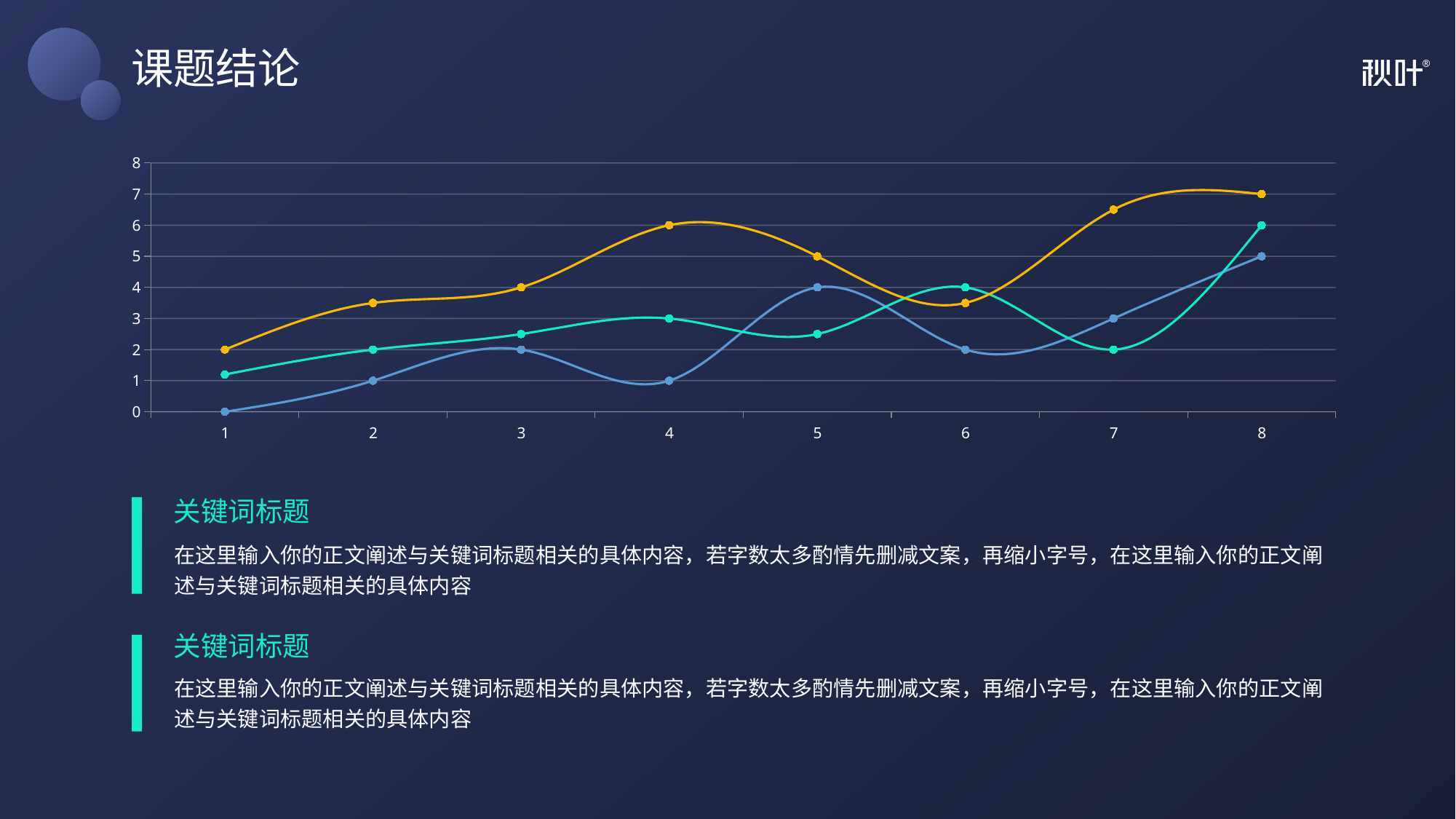
What is the difference between the orange line and the blue line at x = 8? 2 What is the value of the blue line at x = 1? 0 Is the value of the green line at x = 1 greater or less than 2? less At x = 4, which line has the larger value, the orange line or the blue line? orange line Does the orange line overall rise or fall from x = 1 to x = 8? rise At which x value does the blue line reach its lowest point? 1 How many lines are plotted on the chart? 3 What is the value of the green line at x = 8? 6 How many points are plotted along the x axis for each line? 8 What is the value of the orange line at x = 4? 6 At which x value does the orange line reach its highest point? 8 What kind of chart is shown on the slide? line chart